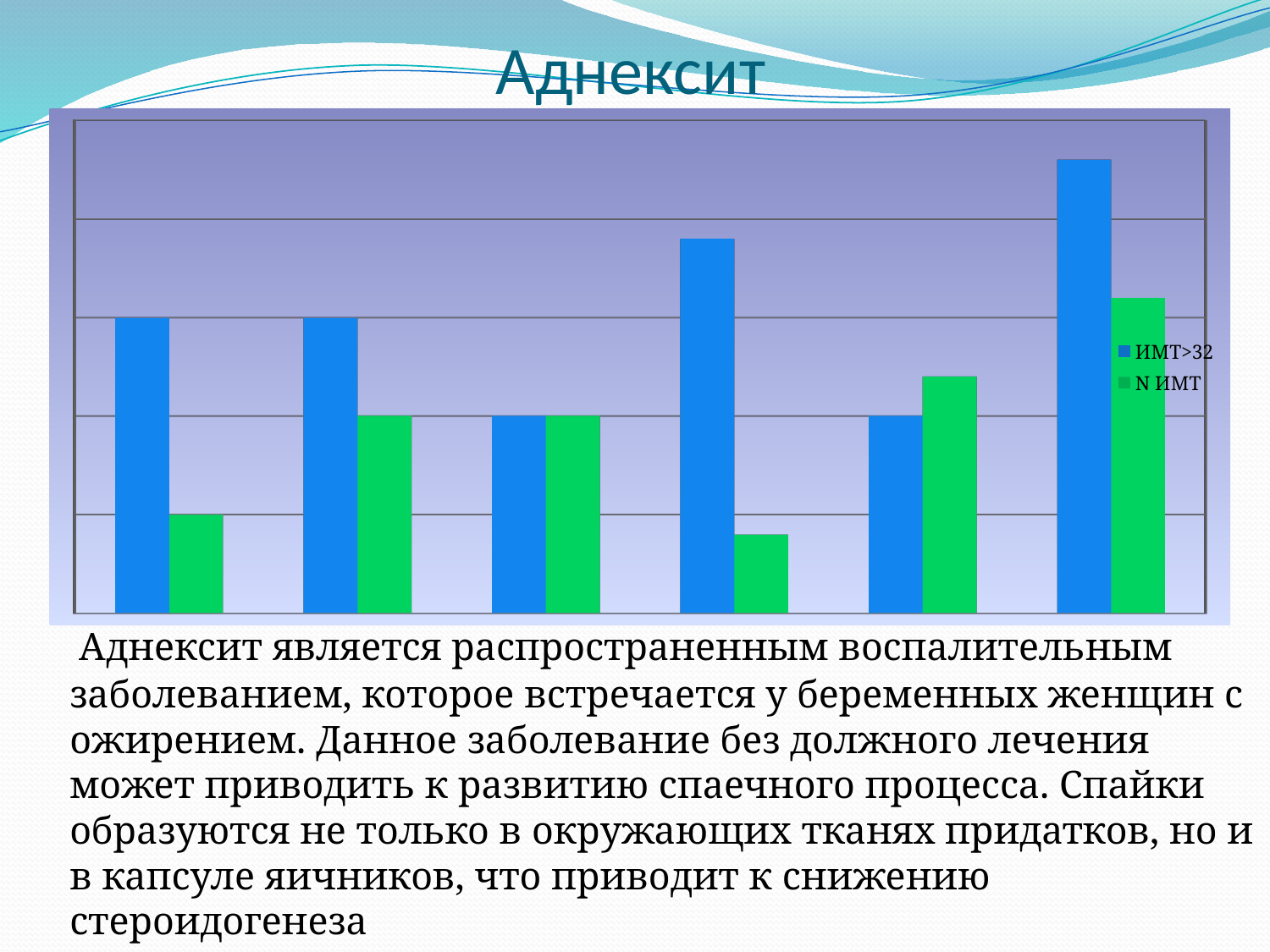
Which group of bars, counting from the left, has the shortest N ИМТ (green) bar? the fourth group How many groups of bars are plotted in the chart? 6 What kind of chart is shown on the slide? bar chart Which group of bars, counting from the left, has the shortest ИМТ>32 (blue) bar? the third and fifth groups (equal) In the fourth group of bars from the left, which series has the larger value, ИМТ>32 or N ИМТ? ИМТ>32 In the fifth group of bars from the left, which series has the larger value, ИМТ>32 or N ИМТ? N ИМТ How many series does the chart legend list? 2 What are the two series named in the chart legend? ИМТ>32 and N ИМТ Which group of bars, counting from the left, has the tallest N ИМТ (green) bar? the sixth (rightmost) group In the first group of bars from the left, which series has the larger value, ИМТ>32 or N ИМТ? ИМТ>32 Which colour represents the ИМТ>32 series in the chart? blue Which group of bars, counting from the left, has the tallest ИМТ>32 (blue) bar? the sixth (rightmost) group